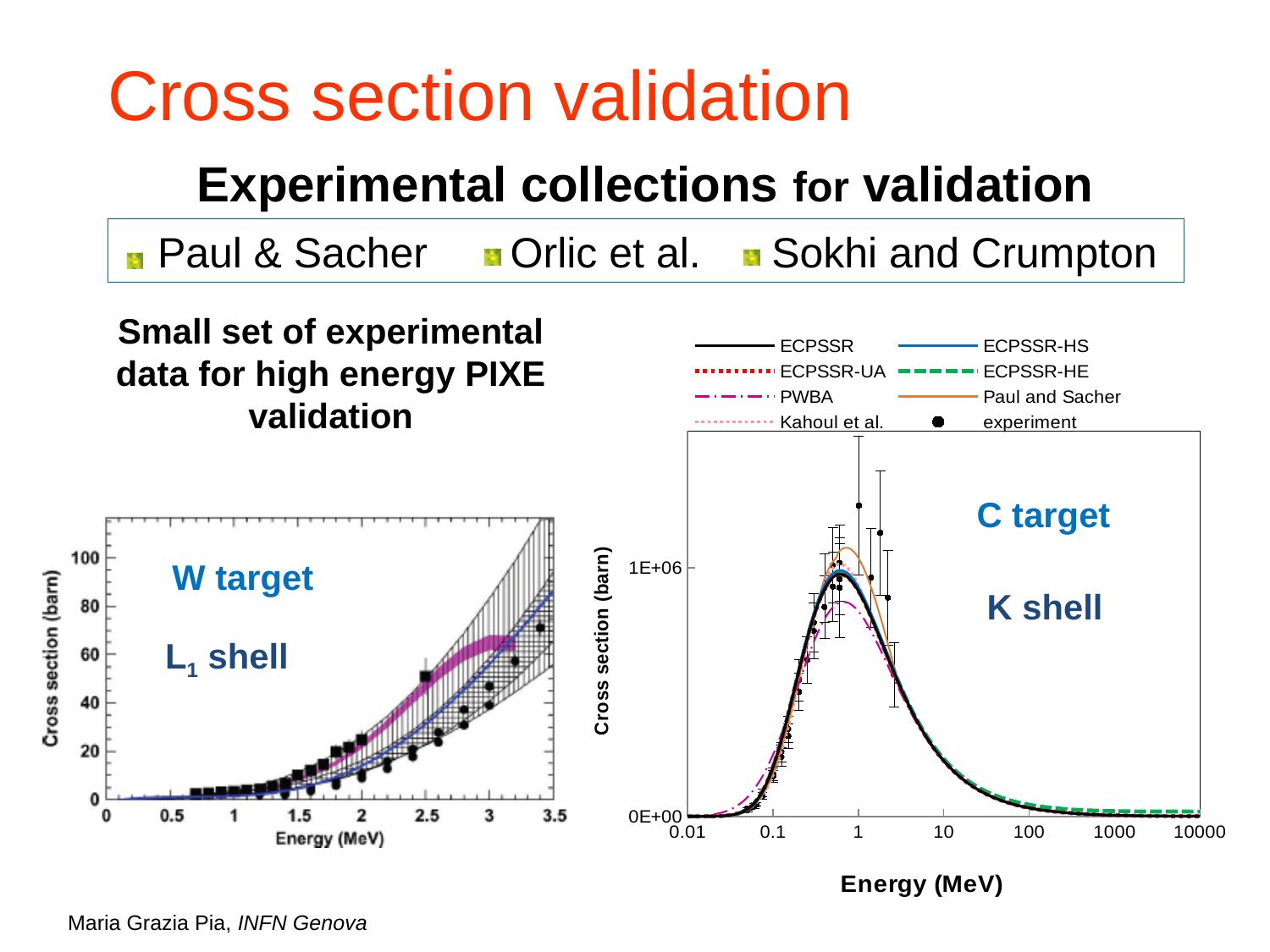
On the right chart (C target), what is the label of the y axis? Cross section (barn) On the right chart (C target), is the peak of the Paul and Sacher curve greater or less than 1E+06? greater On the right chart (C target), what is the label of the x axis? Energy (MeV) On the left chart (W target), is the cross section at 2 MeV greater or less than 40 barn? less On the right chart (C target), do the cross section values rise or fall as energy increases from 10 MeV to 10000 MeV? fall On the left chart (W target), do the cross section values rise or fall as energy increases from 1 MeV to 3.5 MeV? rise On the right chart (C target), which curve has the lowest peak value? PWBA On the right chart (C target), is the peak of the PWBA curve greater or less than 1E+06? less On the right chart (C target), which curve reaches the highest peak value? Paul and Sacher What kind of chart is the right chart (C target, K shell)? Line chart On the right chart (C target), how many series does the legend list? 8 Which shell is shown on the left chart for the W target? L1 shell